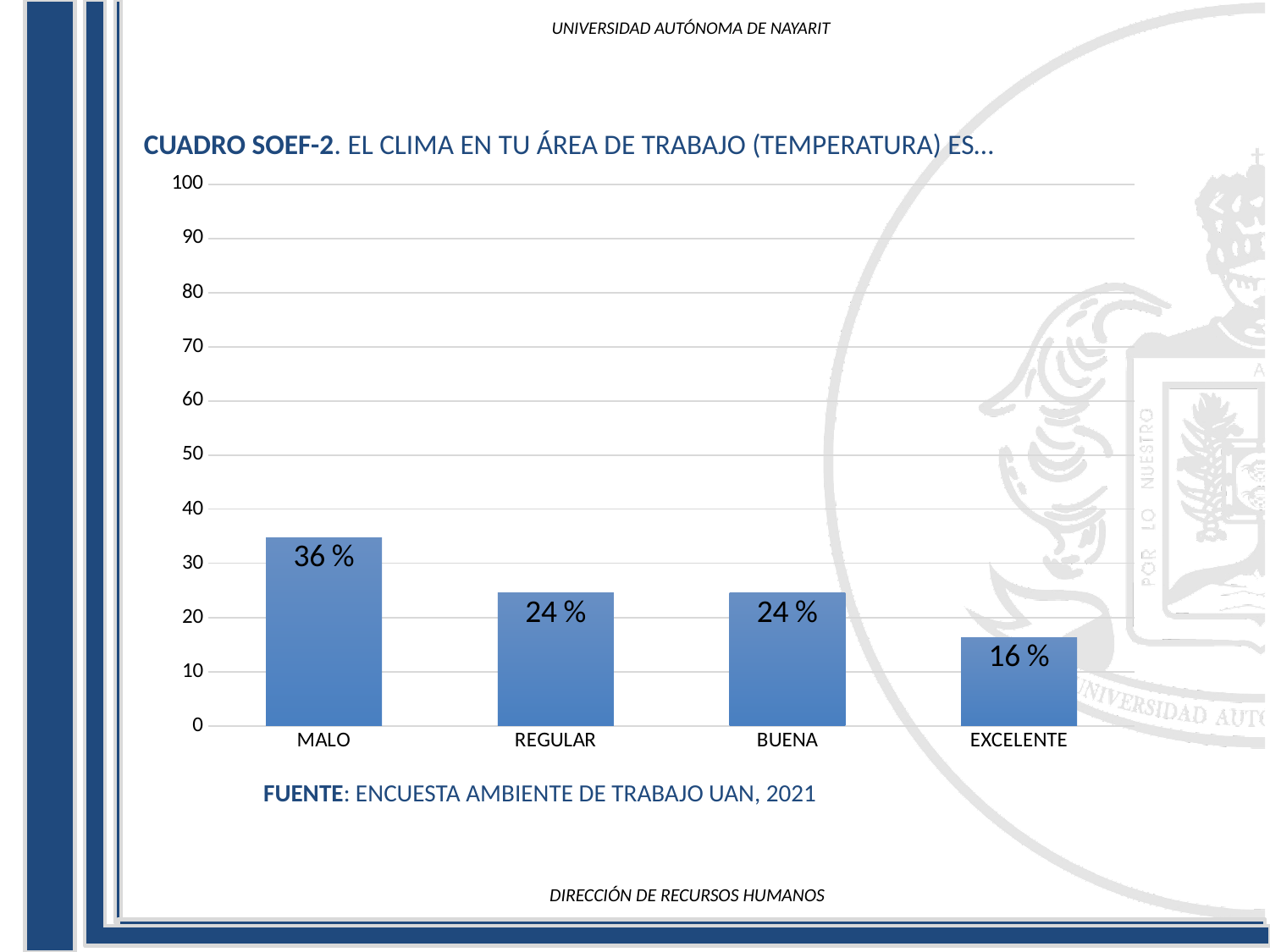
What is the difference between the values for MALO and EXCELENTE? 20 % What kind of chart is shown on the slide? bar chart What is the source cited below the chart? ENCUESTA AMBIENTE DE TRABAJO UAN, 2021 How many categories are shown on the x axis? 4 Is the value for MALO greater or less than 30? greater What is the value for REGULAR? 24 % Which category has the highest value? MALO What is the value for MALO? 36 % Which category has the lowest value? EXCELENTE Which is larger, the value for MALO or the value for REGULAR? MALO What is the value for EXCELENTE? 16 % What is the difference between the values for MALO and BUENA? 12 %